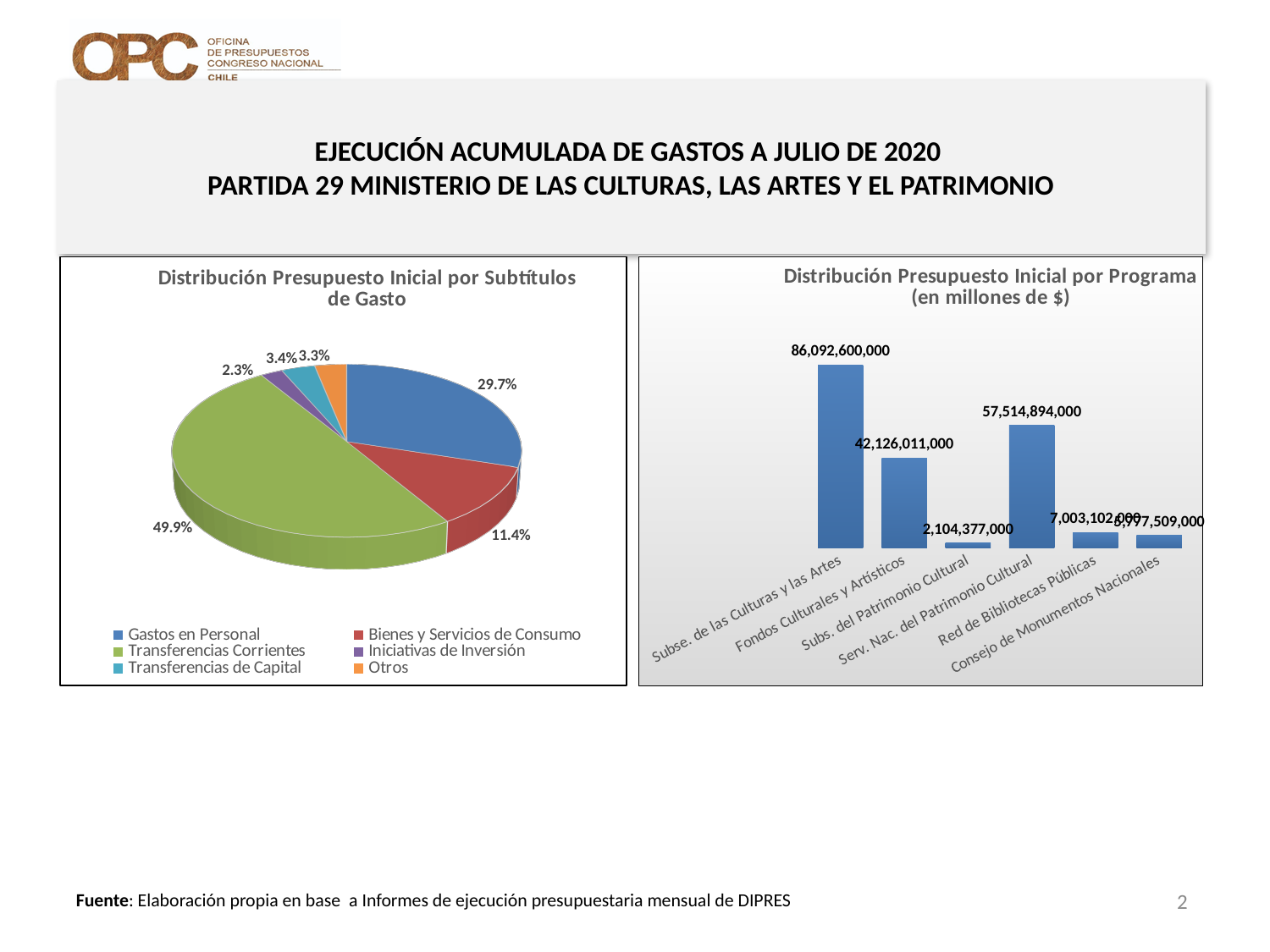
In the pie chart 'Distribución Presupuesto Inicial por Subtítulos de Gasto', how many categories does the legend list? 6 In the chart 'Distribución Presupuesto Inicial por Programa', what is the value for Serv. Nac. del Patrimonio Cultural? 57,514,894,000 In the pie chart 'Distribución Presupuesto Inicial por Subtítulos de Gasto', what share does Transferencias Corrientes have? 49.9% In the pie chart 'Distribución Presupuesto Inicial por Subtítulos de Gasto', which category has the smallest slice? Iniciativas de Inversión What kind of chart is 'Distribución Presupuesto Inicial por Programa'? Bar chart In the chart 'Distribución Presupuesto Inicial por Programa', what is the difference between Subse. de las Culturas y las Artes and Fondos Culturales y Artísticos? 43,966,589,000 In the chart 'Distribución Presupuesto Inicial por Programa', which program has the lowest value? Subs. del Patrimonio Cultural In the chart 'Distribución Presupuesto Inicial por Programa', which program has the highest value? Subse. de las Culturas y las Artes In the chart 'Distribución Presupuesto Inicial por Programa', what is the value for Subse. de las Culturas y las Artes? 86,092,600,000 In the pie chart 'Distribución Presupuesto Inicial por Subtítulos de Gasto', which category has the largest slice? Transferencias Corrientes In the pie chart 'Distribución Presupuesto Inicial por Subtítulos de Gasto', what share does Gastos en Personal have? 29.7% What kind of chart is 'Distribución Presupuesto Inicial por Subtítulos de Gasto'? Pie chart